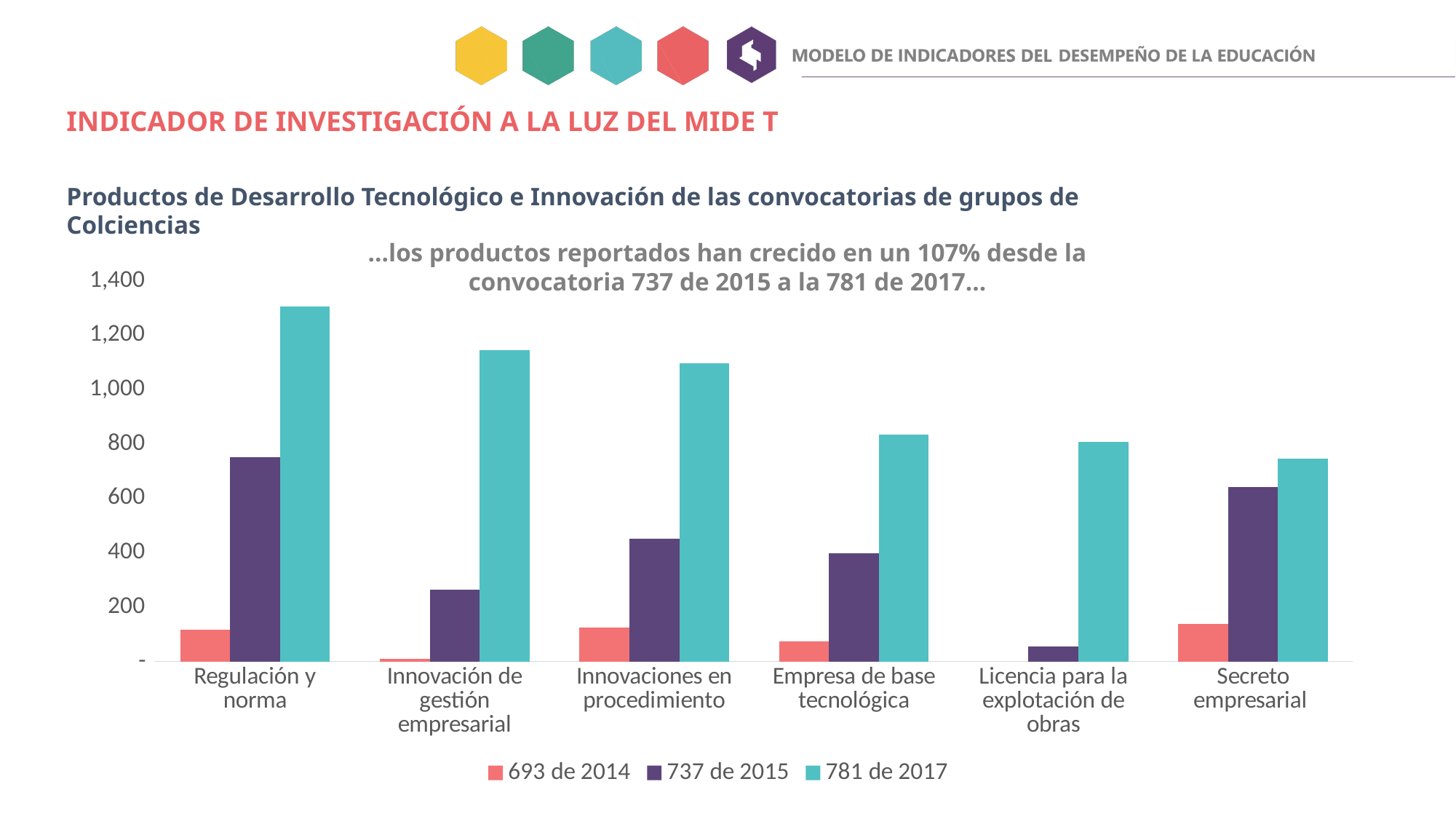
Within each category, which series has the tallest bar? 781 de 2017 Which category has the highest value for the 737 de 2015 series? Regulación y norma For the 737 de 2015 series, which is larger: Secreto empresarial or Innovaciones en procedimiento? Secreto empresarial Is the 781 de 2017 value for Licencia para la explotación de obras greater or less than 1,000? less What are the three legend entries of the chart? 693 de 2014, 737 de 2015, 781 de 2017 How many categories are shown on the x axis? 6 Which category has the highest value for the 781 de 2017 series? Regulación y norma Is the 737 de 2015 value for Innovación de gestión empresarial greater or less than 400? less How many series does the legend list? 3 What kind of chart is shown on the slide? bar chart Is the 781 de 2017 value for Regulación y norma greater or less than 1,200? greater Which category has the lowest value for the 781 de 2017 series? Secreto empresarial